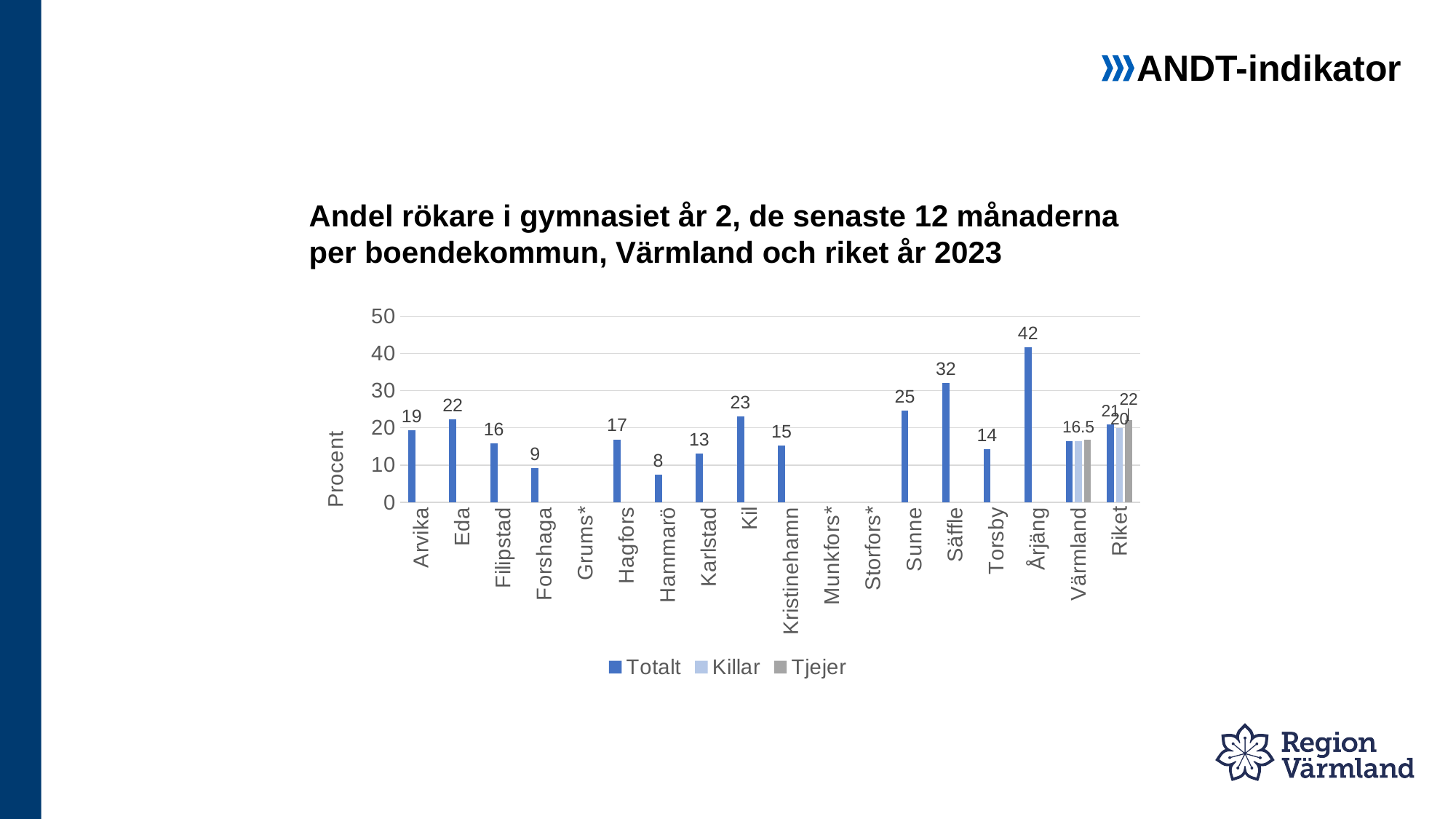
What is the difference between the values for Årjäng and Säffle? 10 What is the value for Säffle? 32 How many categories are shown on the x axis? 18 Which municipality has the highest share of smokers in the chart? Årjäng What are the three legend entries of the chart? Totalt, Killar, Tjejer How many series does the legend list? 3 Is the value for Forshaga greater or less than 10? less Which municipality with a plotted bar has the lowest share of smokers? Hammarö What is the Totalt value for Riket? 21 Which has a higher value, Sunne or Eda? Sunne What kind of chart is shown on the slide? Bar chart What is the value for Kil? 23